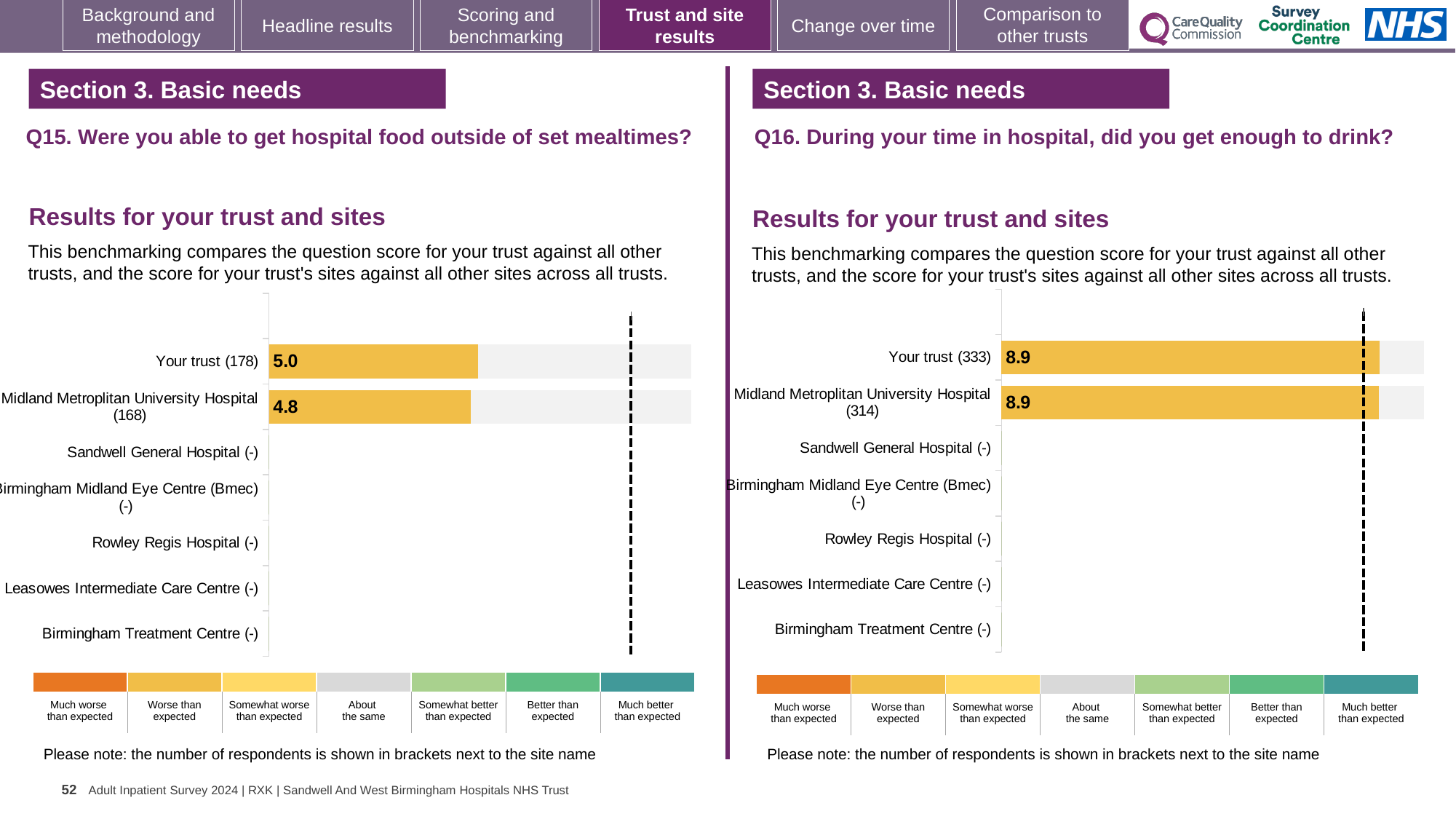
On the Q15 chart (left), what is the score for Your trust (178)? 5.0 On the Q16 chart (right), how many respondents are shown in brackets for Midland Metropolitan University Hospital? 314 How many site/trust categories are listed on the Q15 chart (left)? 7 On the Q15 chart (left), what is the score for Midland Metropolitan University Hospital (168)? 4.8 On the Q16 chart (right), what is the score for Midland Metropolitan University Hospital (314)? 8.9 On the Q15 chart (left), what is the difference between the score for Your trust and the score for Midland Metropolitan University Hospital? 0.2 On the Q15 chart (left), how many respondents are shown in brackets for Your trust? 178 On the Q16 chart (right), what is the score for Your trust (333)? 8.9 What type of chart is used on the Q16 chart (right)? Bar chart On the Q15 chart (left), which has the higher score: Your trust or Midland Metropolitan University Hospital? Your trust How many site/trust categories are listed on the Q16 chart (right)? 7 On the Q16 chart (right), what is the difference between the score for Your trust and the score for Midland Metropolitan University Hospital? 0